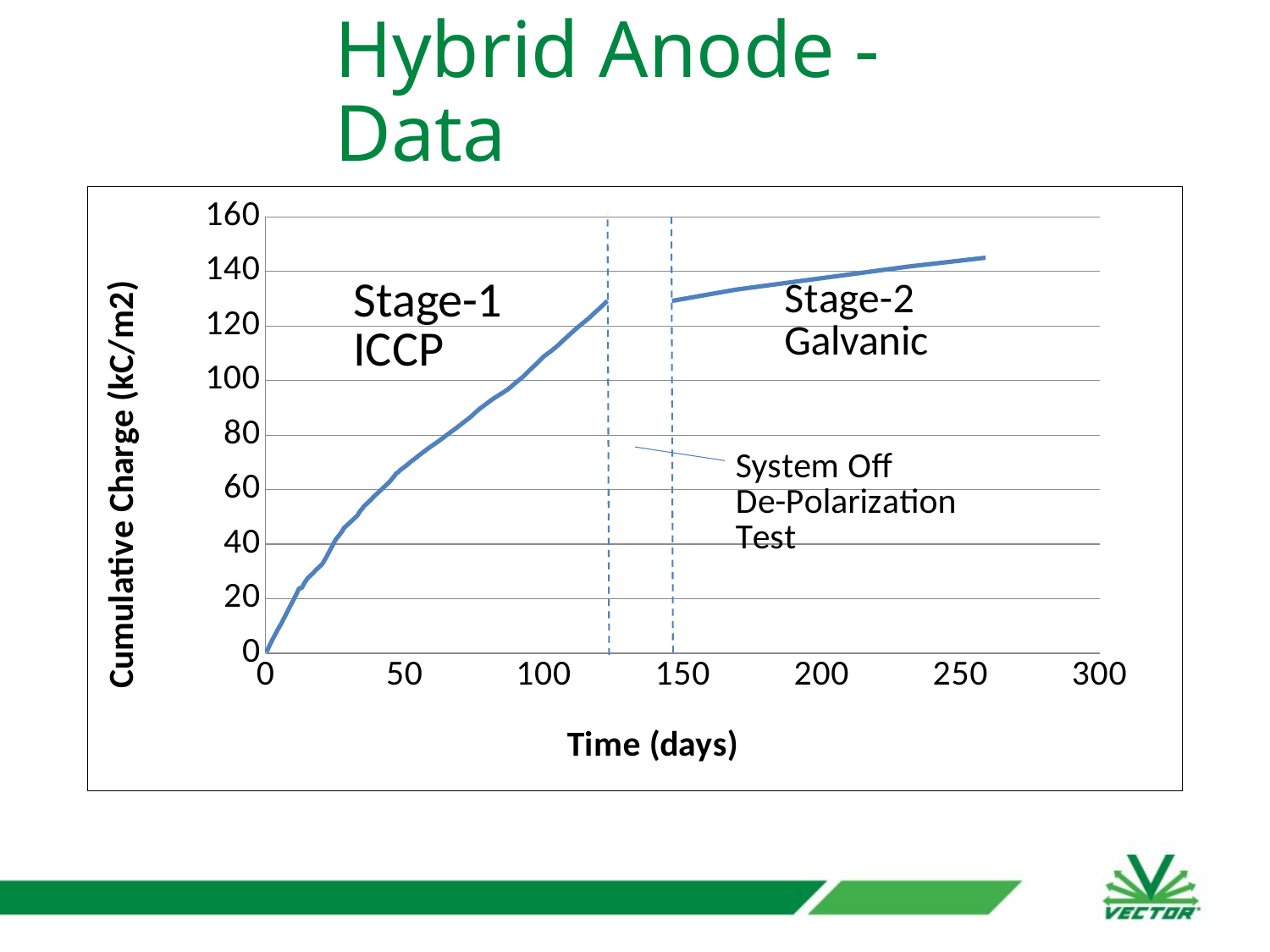
What is the highest value shown on the x axis? 300 Is the cumulative charge at 100 days greater or less than 80? greater What is the title of the x axis? Time (days) Is the cumulative charge at 200 days greater or less than 120? greater Is the cumulative charge at 50 days greater or less than 80? less Which is larger, the cumulative charge at 50 days or at 200 days? 200 days Does the cumulative charge rise or fall as time increases? rise What kind of chart is shown on the slide? line chart What is the title of the y axis? Cumulative Charge (kC/m2)